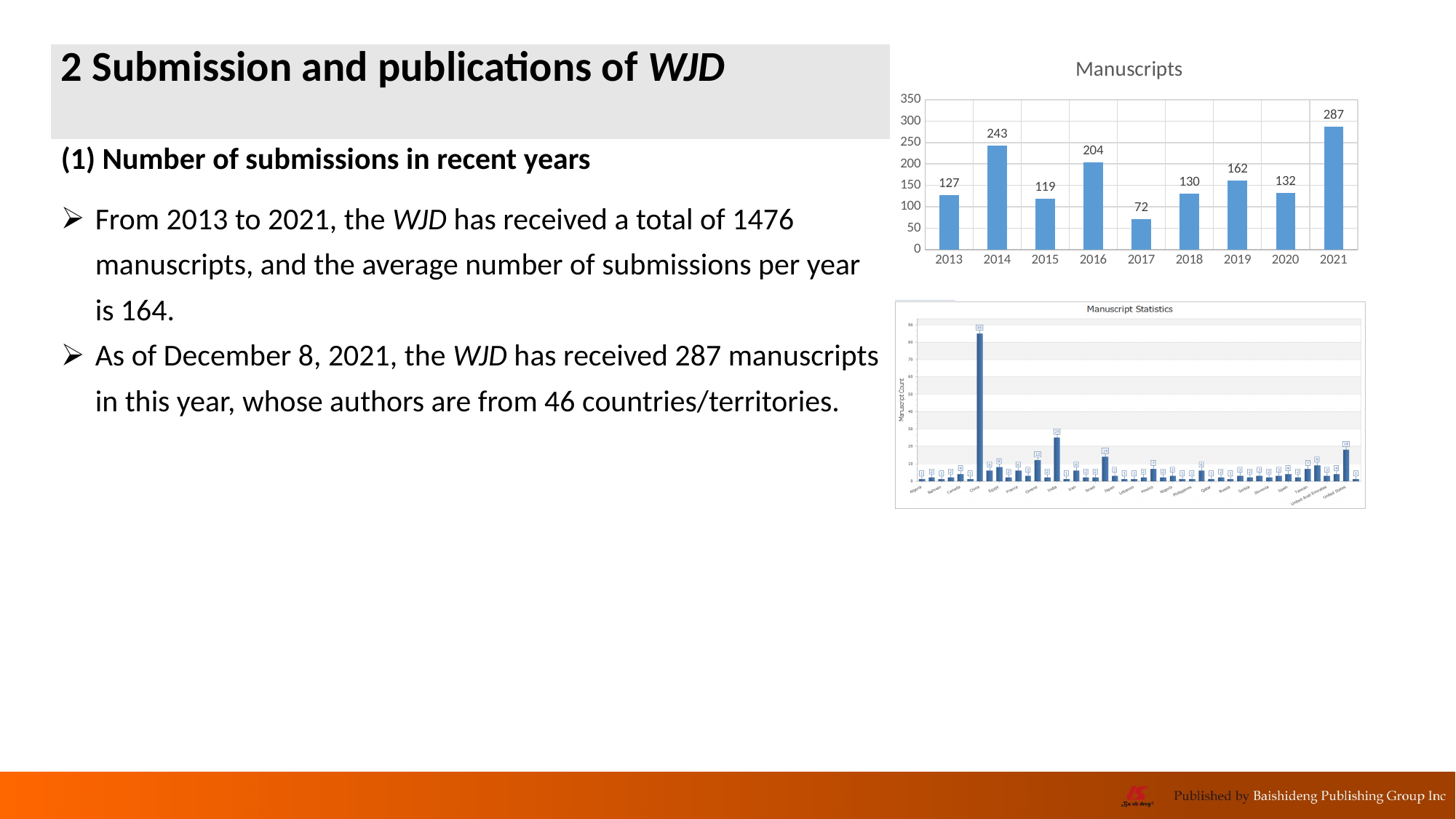
In the 'Manuscripts' chart, is the value for 2016 greater or less than 200? greater In the 'Manuscripts' chart, which year has the lowest number of manuscripts? 2017 In the 'Manuscripts' chart, what is the value for 2017? 72 In the 'Manuscripts' chart, which is larger, the value for 2018 or the value for 2020? 2020 How many years are shown on the x axis of the 'Manuscripts' chart? 9 In the 'Manuscripts' chart, what is the value for 2019? 162 In the 'Manuscripts' chart, what is the difference between the values for 2016 and 2015? 85 In the 'Manuscript Statistics' chart at the bottom right, which country has the tallest bar? China In the 'Manuscripts' chart, how many manuscripts were received in 2014? 243 In the 'Manuscripts' chart, what is the difference between the values for 2021 and 2020? 155 In the 'Manuscripts' chart, which year has the highest number of manuscripts? 2021 What type of chart is the 'Manuscripts' chart? bar chart